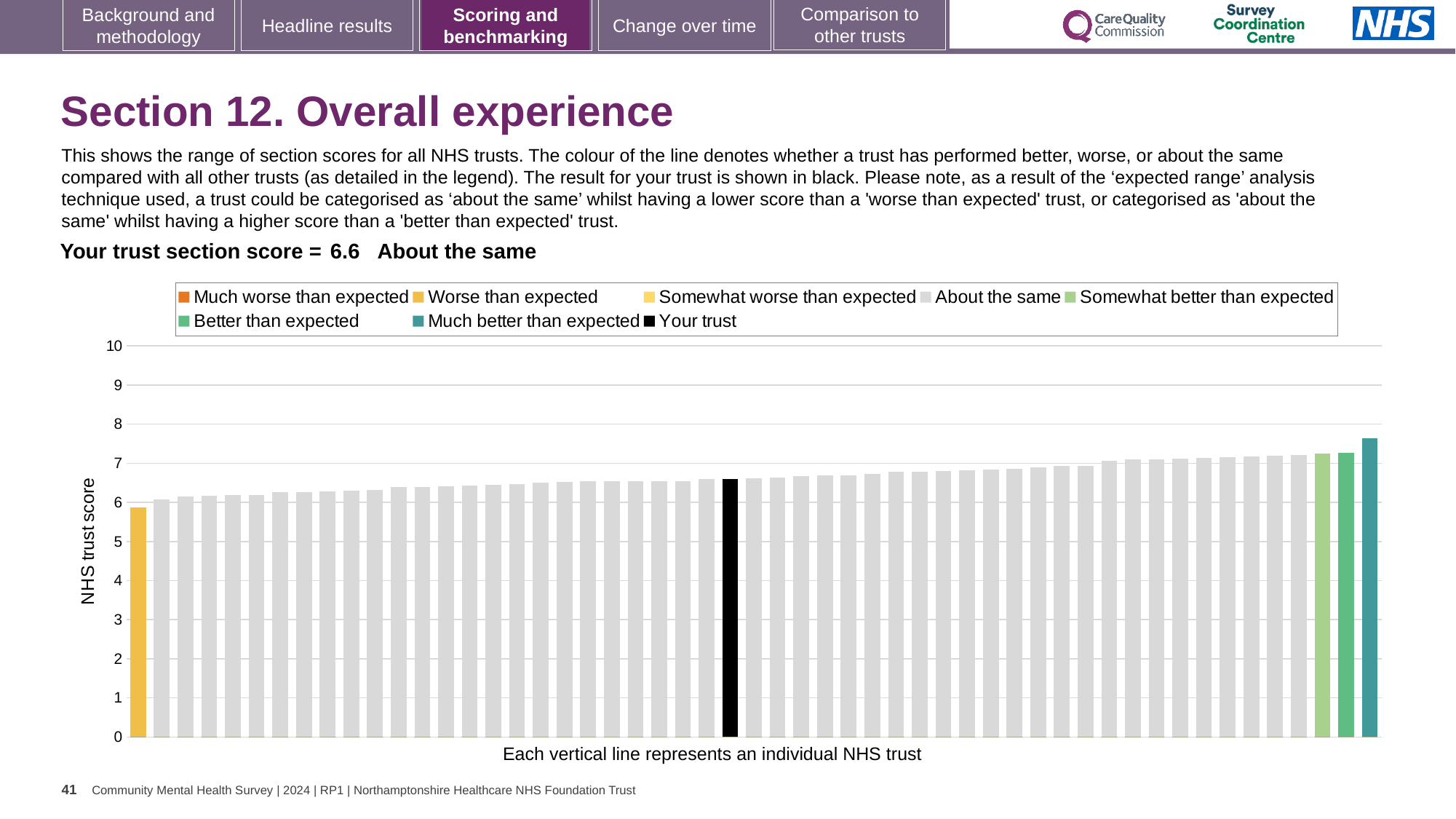
Do the bar values rise or fall from left to right along the x axis? rise Is the value of the rightmost bar greater or less than 7? greater What is the label on the vertical axis of the chart? NHS trust score Which legend category does the highest bar belong to? Much better than expected How many entries does the chart legend list? 8 What is the section score for your trust shown on the slide? 6.6 Which legend category does the lowest bar belong to? Worse than expected Is the value of the black 'Your trust' bar greater or less than 6? greater What colour is the bar representing your trust? black Is the bar for your trust higher or lower than the rightmost bar? lower What kind of chart is shown on the slide? bar chart Is the value of the black 'Your trust' bar greater or less than 7? less